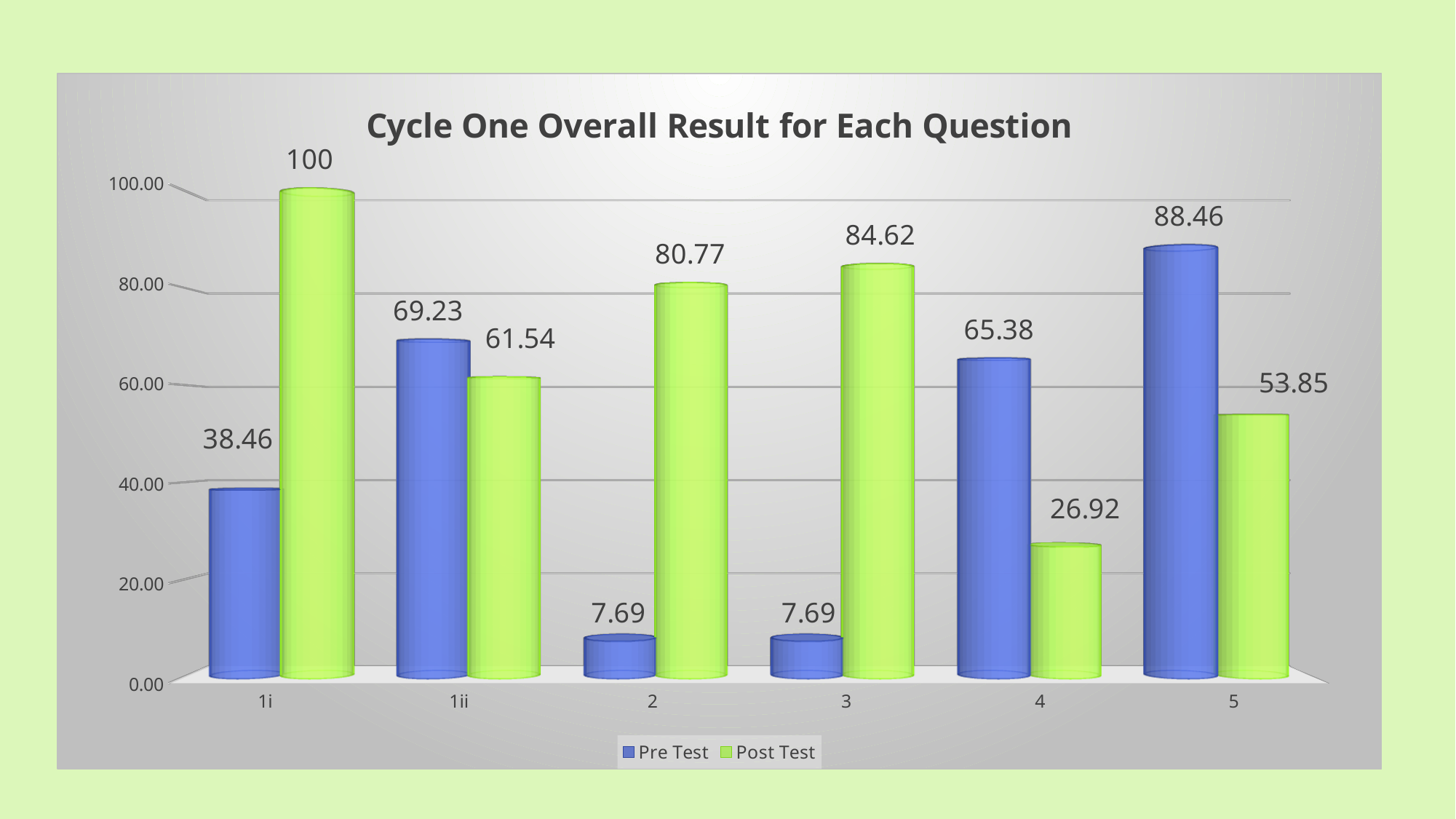
What kind of chart is shown on the slide? Bar chart What is the Post Test value for question 4? 26.92 What is the Pre Test value for question 5? 88.46 What is the difference between the Post Test and Pre Test values for question 2? 73.08 How many questions (categories) are shown on the x axis? 6 What is the Post Test value for question 1i? 100 Which question has the lowest Post Test value? 4 Which question has the highest Post Test value? 1i What is the title of the chart? Cycle One Overall Result for Each Question Which is larger for question 4, the Pre Test or the Post Test value? Pre Test Which question has the highest Pre Test value? 5 How many series does the legend list? 2